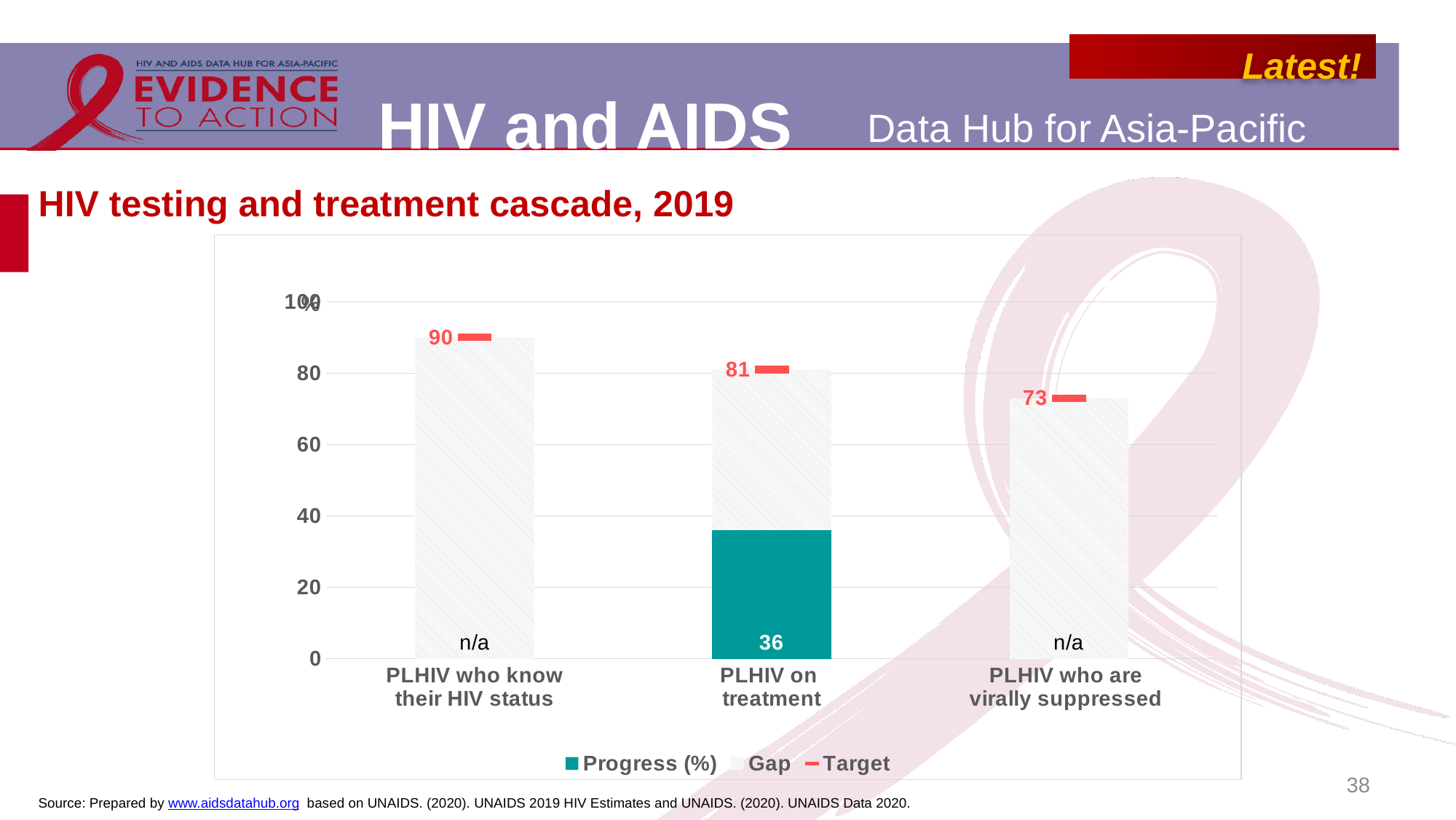
How many series does the chart legend list? 3 Which category has the lowest Target value? PLHIV who are virally suppressed What is the Target value shown for PLHIV who are virally suppressed? 73 What is the Progress (%) value shown for PLHIV on treatment? 36 What Progress (%) value is shown for PLHIV who know their HIV status? n/a What is the Target value shown for PLHIV who know their HIV status? 90 Is the Progress (%) value for PLHIV on treatment greater or less than 40? less Which category has the highest Target value? PLHIV who know their HIV status What is the difference between the Target for PLHIV who know their HIV status and the Target for PLHIV who are virally suppressed? 17 How many categories are shown on the x axis of the chart? 3 What is the Target value shown for PLHIV on treatment? 81 Which is larger: the Target for PLHIV on treatment or the Target for PLHIV who are virally suppressed? PLHIV on treatment